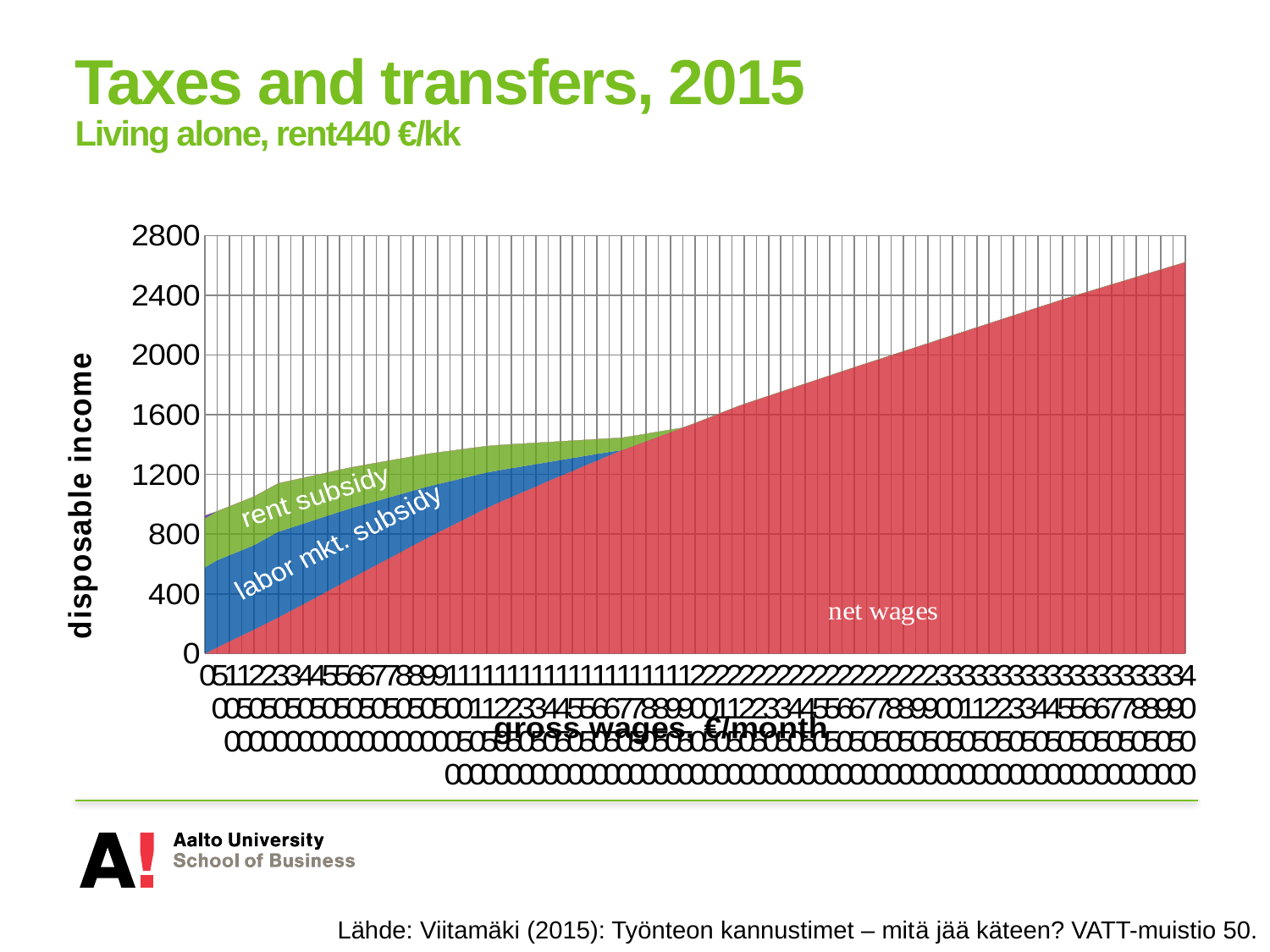
Does the net wages component rise or fall as gross wages increase along the x axis? rise What kind of chart is shown on the slide? stacked area chart At the highest gross wage shown (right edge of the chart), is total disposable income greater or less than 2400? greater Does the labor mkt. subsidy component rise or fall as gross wages increase along the x axis? fall At the left edge of the chart, which component is larger: net wages or labor mkt. subsidy? labor mkt. subsidy How many series (components of disposable income) are labelled in the chart? 3 At the lowest gross wage shown (left edge of the chart), is total disposable income greater or less than 1200? less What is the highest value shown on the vertical axis? 2800 At the right edge of the chart, which component makes up the largest share of disposable income? net wages Which series is shown in red in the chart? net wages What is the title of the vertical axis? disposable income